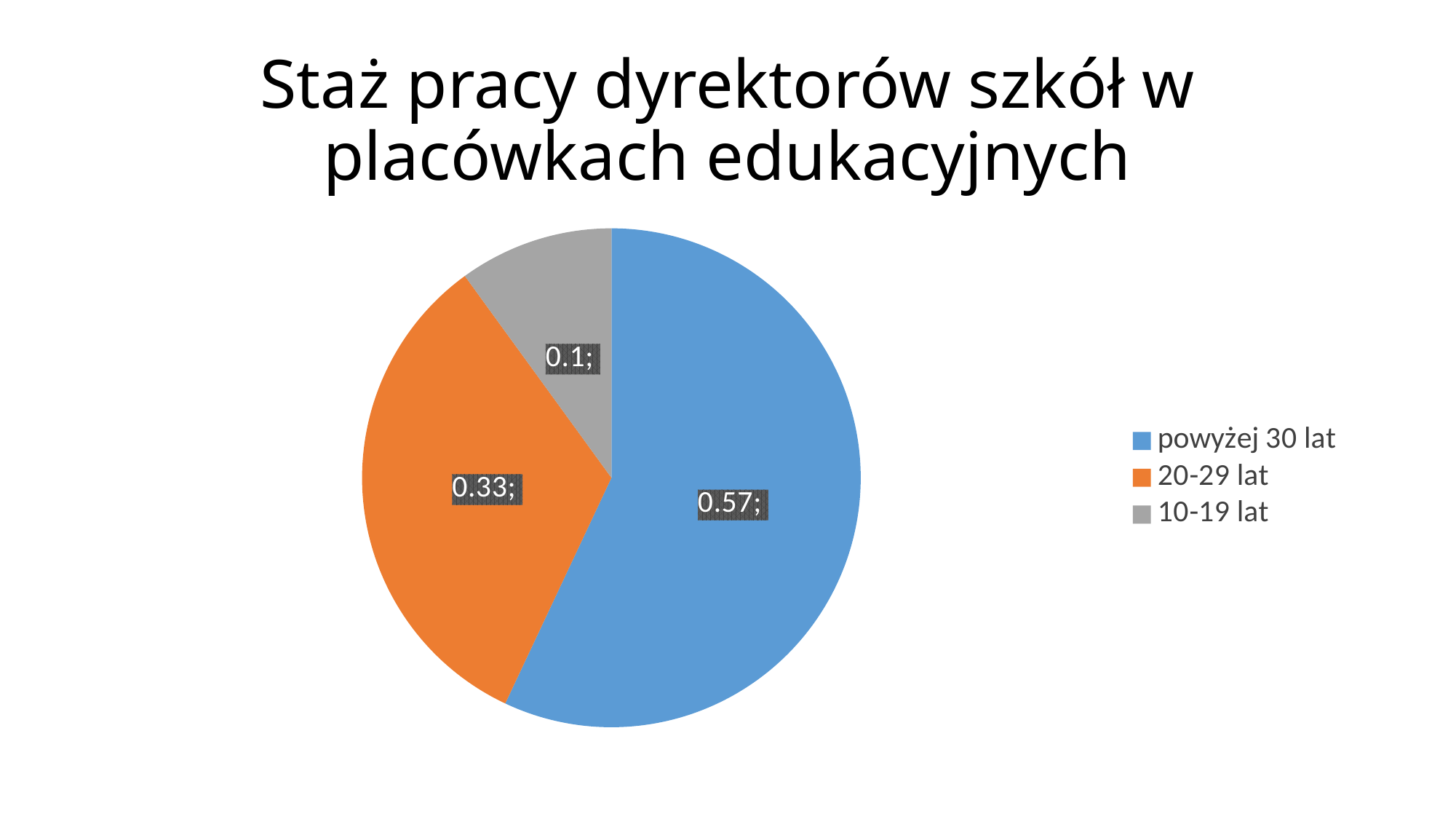
What is the value shown for the '20-29 lat' slice? 0.33 What is the difference between the values for '20-29 lat' and '10-19 lat'? 0.23 What is the title of the chart? Staż pracy dyrektorów szkół w placówkach edukacyjnych How many categories does the pie chart show? 3 What kind of chart is shown on the slide? pie chart Which category has the largest slice of the pie? powyżej 30 lat What is the value shown for the 'powyżej 30 lat' slice? 0.57 Which category has the smallest slice of the pie? 10-19 lat What is the value shown for the '10-19 lat' slice? 0.1 What is the difference between the values for 'powyżej 30 lat' and '20-29 lat'? 0.24 What colour is the slice for '20-29 lat'? orange Which is larger, the slice for '20-29 lat' or the slice for '10-19 lat'? 20-29 lat